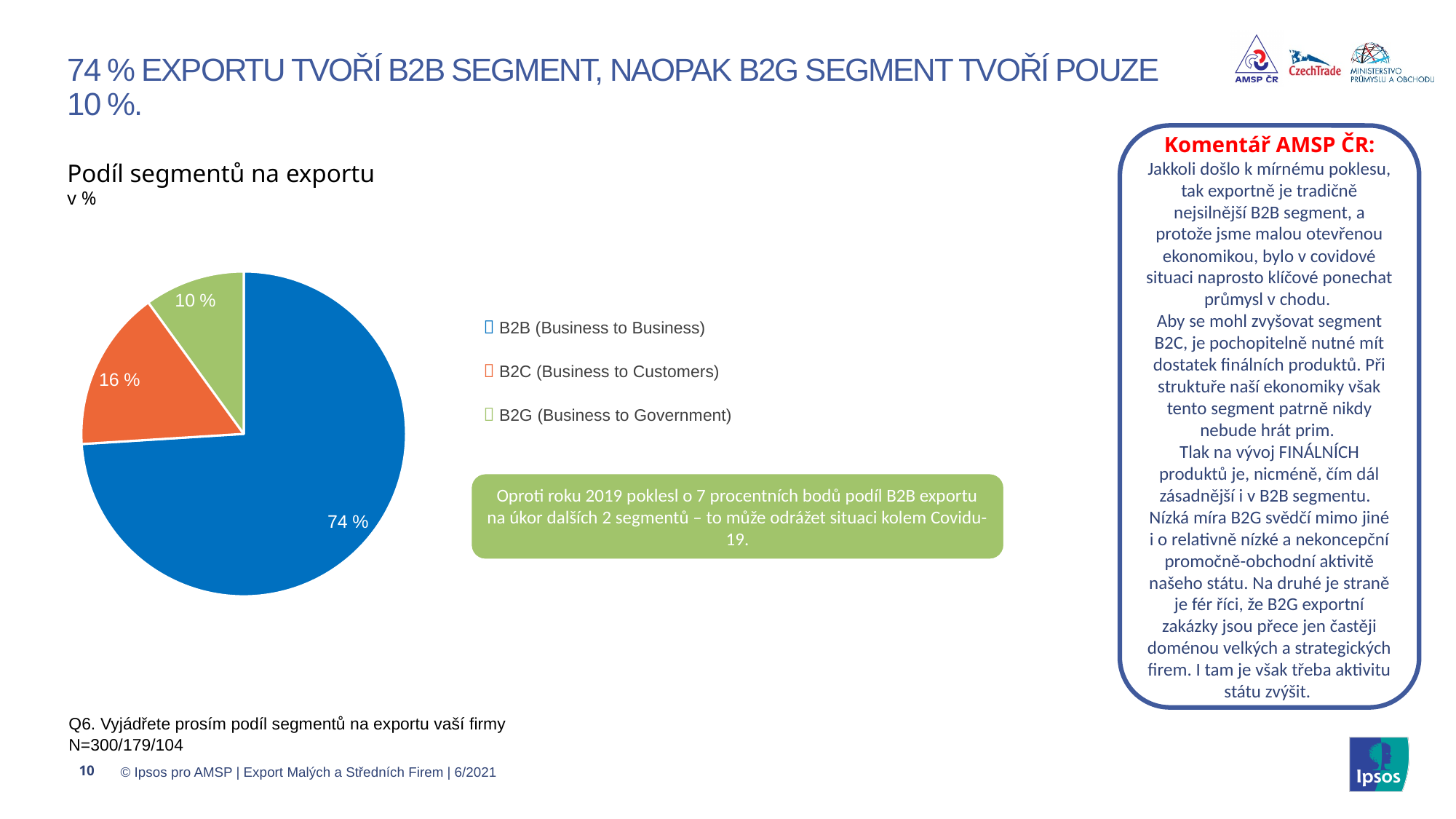
Which colour represents the B2G (Business to Government) segment in the pie chart? Green What share of export does the B2C (Business to Customers) segment have? 16 % How many segments are shown in the pie chart? 3 Which segment has the largest share of export? B2B (Business to Business) Which segment has a larger share, B2C or B2G? B2C (Business to Customers) What share of export does the B2G (Business to Government) segment have? 10 % Which segment has the smallest share of export? B2G (Business to Government) What is the difference in percentage points between the B2B and B2C shares? 58 What is the difference in percentage points between the B2C and B2G shares? 6 What is the title of the chart? Podíl segmentů na exportu What kind of chart is shown on the slide? Pie chart What share of export does the B2B (Business to Business) segment have? 74 %